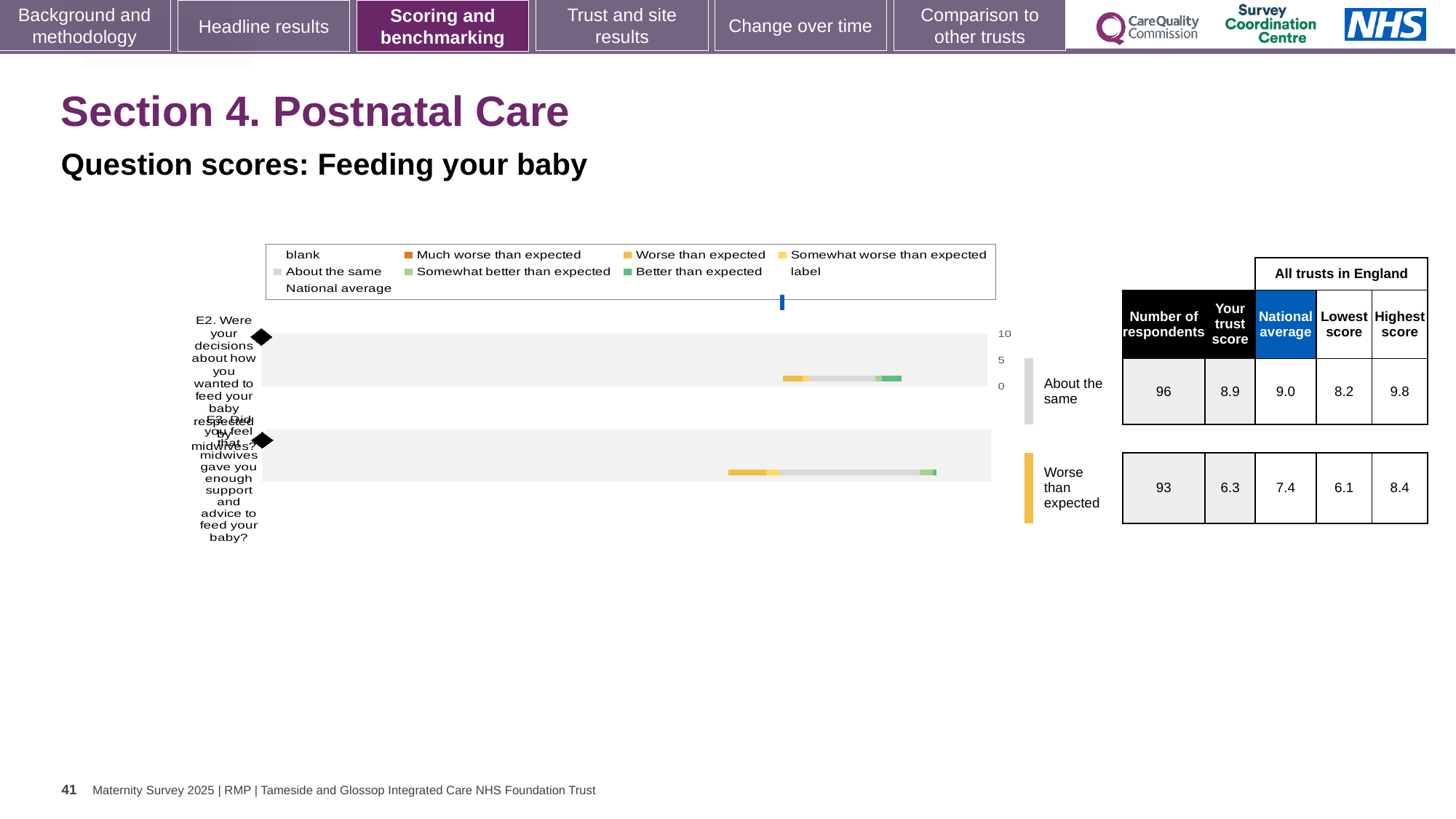
How many respondents answered question E3? 93 What kind of chart is used to show the question scores for Feeding your baby? bar chart Which question has the lower trust score, E2 or E3? E3 Which benchmark category is question E3 rated as? Worse than expected What is the trust score for question E2 (decisions about how you wanted to feed your baby respected by midwives)? 8.9 Which question has more respondents, E2 or E3? E2 What is the national average for question E3 (midwives gave enough support and advice to feed your baby)? 7.4 What is the highest score across all trusts in England for question E2? 9.8 How many questions are plotted in the Feeding your baby chart? 2 What is the difference between the national average and the trust score for question E3? 1.1 What is the lowest score across all trusts in England for question E3? 6.1 Which benchmark category is question E2 rated as? About the same